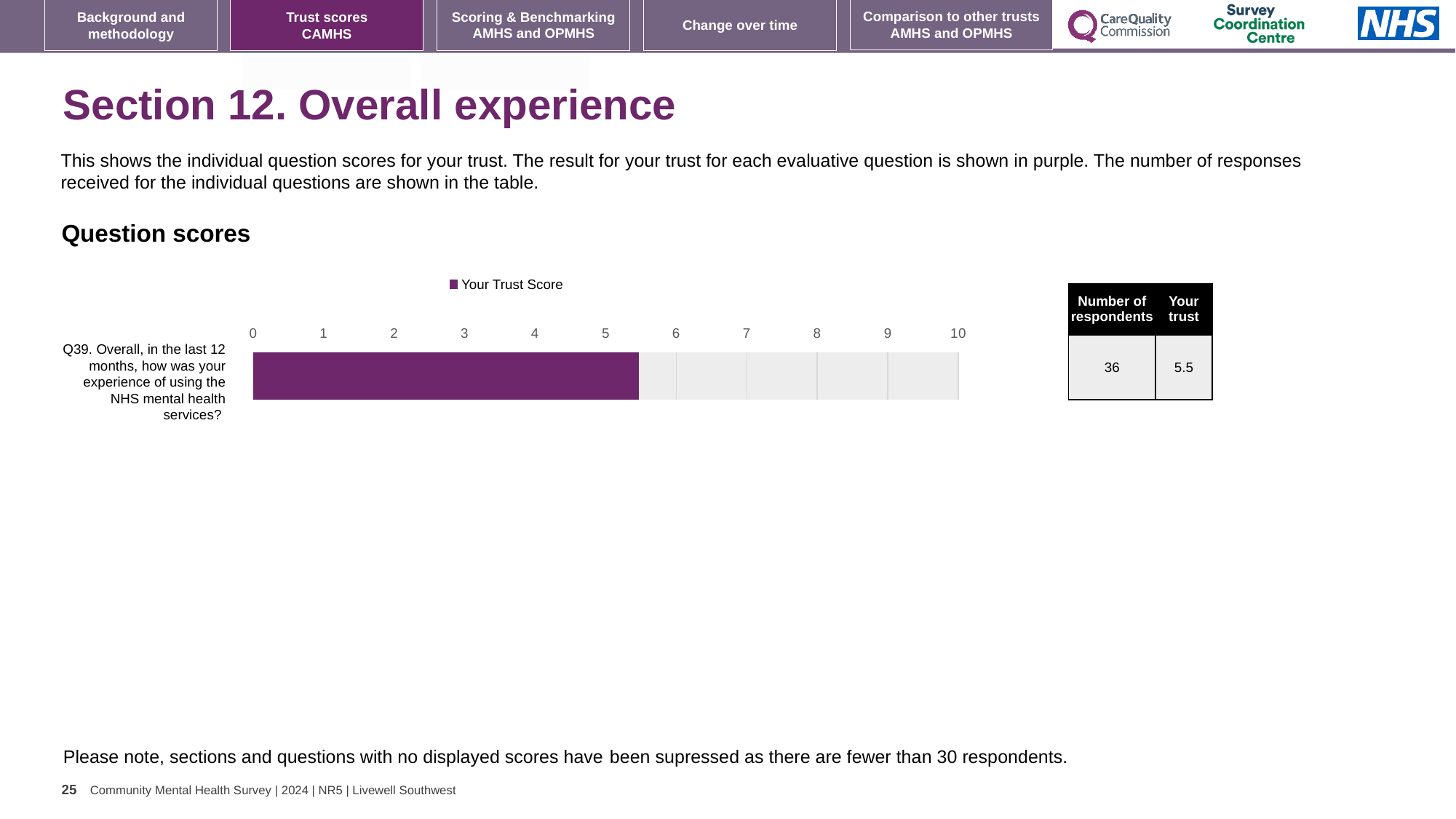
How many series does the legend of the chart list? 1 What is the name of the series shown in the chart legend? Your Trust Score Is the bar for Q39 greater or less than 8 on the axis? less What kind of chart is shown under 'Question scores'? bar chart Is the bar for Q39 greater or less than 6 on the axis? less What is the trust score for Q39 (Overall, in the last 12 months, how was your experience of using the NHS mental health services?)? 5.5 How many questions (categories) are plotted in the chart? 1 What is the maximum value shown on the chart's axis? 10 How many respondents answered Q39 according to the table next to the chart? 36 Is the bar for Q39 greater or less than 5 on the axis? greater